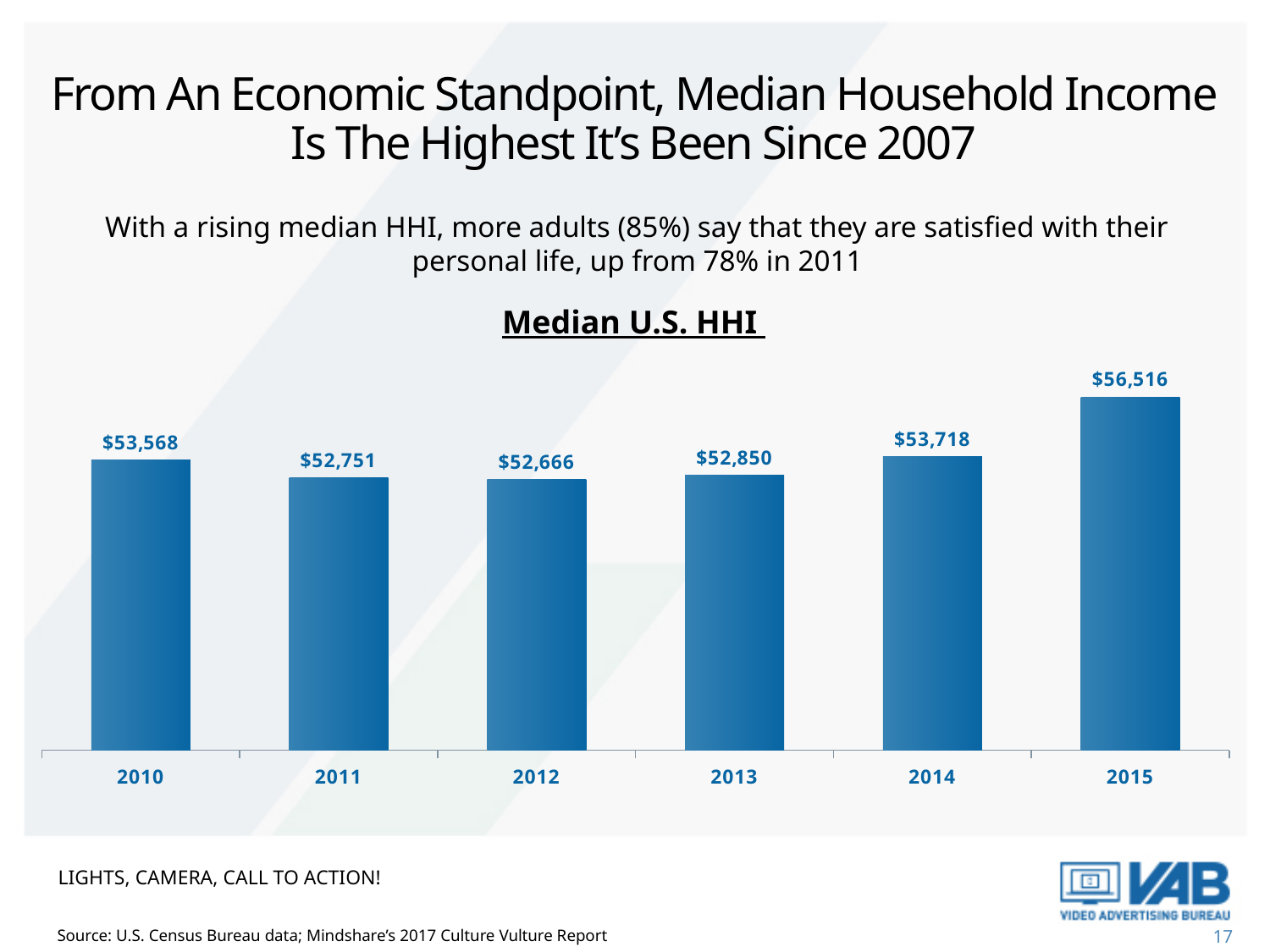
What kind of chart is used to show Median U.S. HHI? Bar chart Which year has the lowest median U.S. HHI on the chart? 2012 What is the median U.S. HHI shown for 2012? $52,666 What is the difference between the median U.S. HHI in 2010 and in 2011? $817 How many years are shown on the Median U.S. HHI chart? 6 Which year has the highest median U.S. HHI on the chart? 2015 What is the difference between the median U.S. HHI in 2015 and in 2014? $2,798 What is the title of the chart on the slide? Median U.S. HHI Which year has a higher median U.S. HHI, 2013 or 2014? 2014 Does the median U.S. HHI rise or fall from 2012 to 2015? Rise What is the median U.S. HHI shown for 2015? $56,516 What is the median U.S. HHI shown for 2010? $53,568